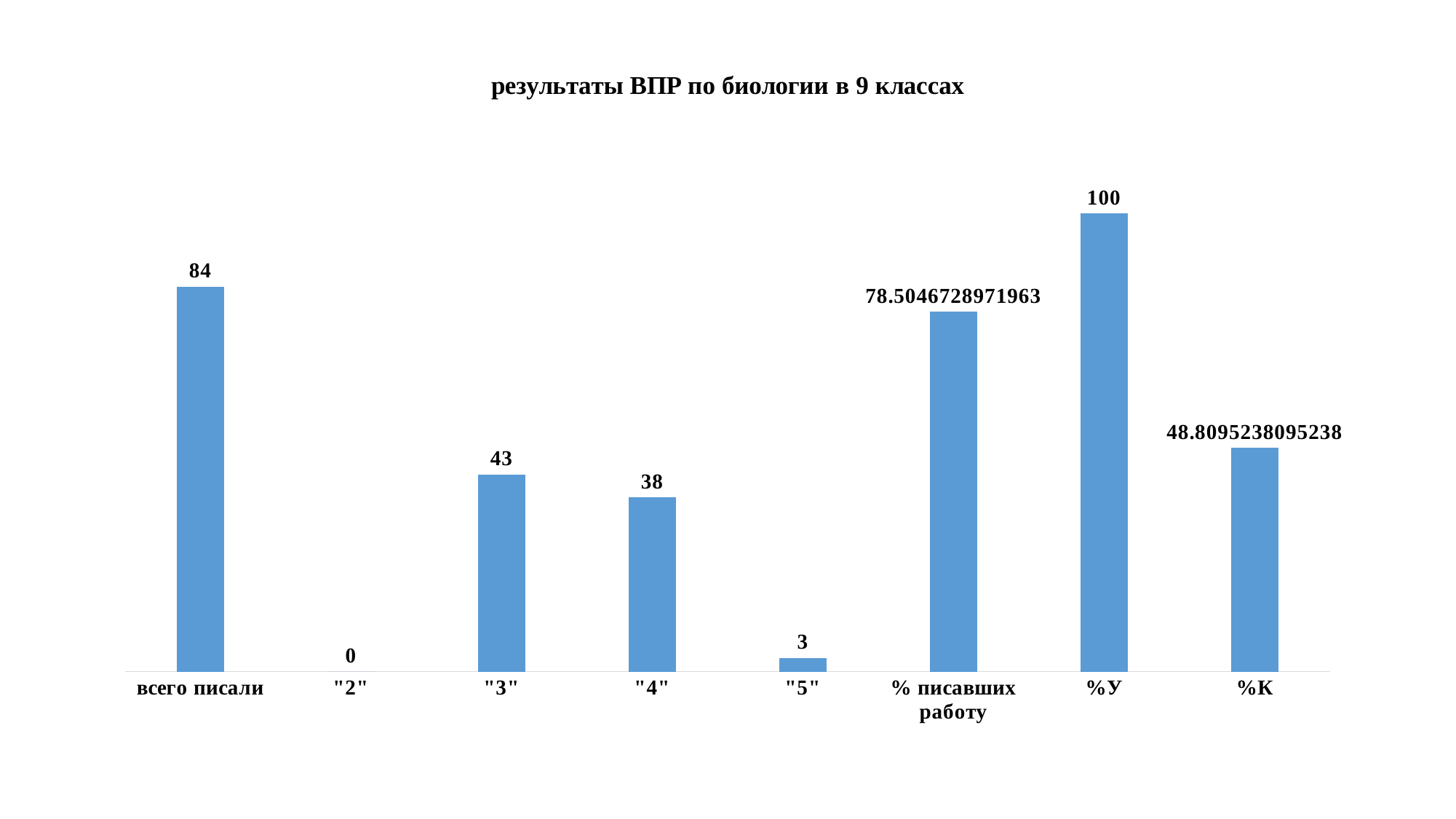
What is the value for "4"? 38 Which category has the highest value? %У Which is larger, the value for "всего писали" or the value for "% писавших работу"? всего писали How many categories are shown on the x axis? 8 What is the title of the chart? результаты ВПР по биологии в 9 классах What is the value for "%К"? 48.8095238095238 What is the value for "3"? 43 What is the value for "всего писали"? 84 What is the value for "%У"? 100 What is the value for "5"? 3 Which category has the lowest value? "2" What is the difference between the values for "3" and "4"? 5